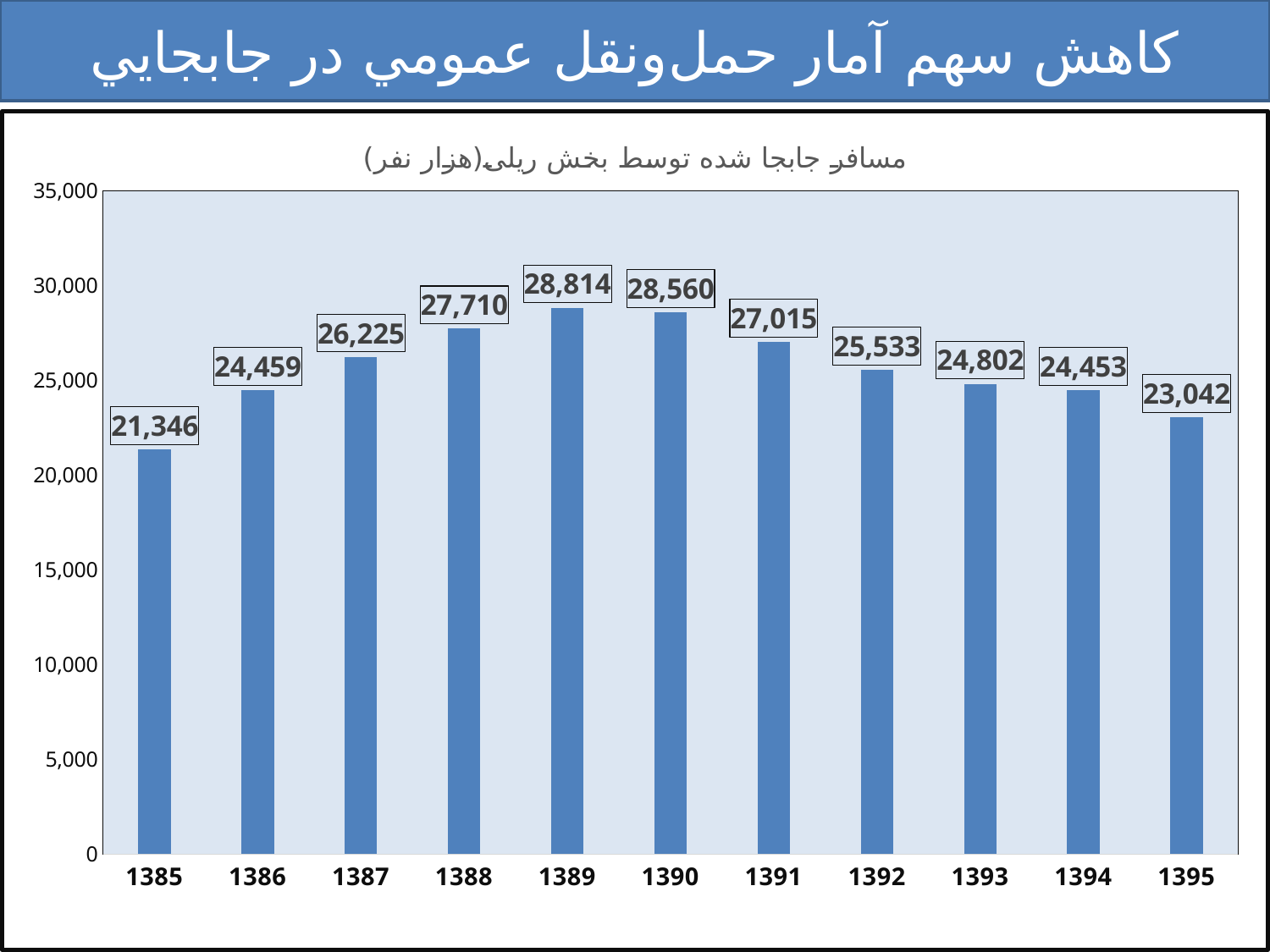
Do the values rise or fall from 1390 to 1395? Fall What is the value for 1385? 21,346 What is the difference between the values for 1389 and 1395? 5,772 What kind of chart is shown on the slide? Bar chart Which is larger, the value for 1388 or the value for 1391? 1388 Which year has the lowest value? 1385 What is the value for 1395? 23,042 What is the title of the chart? مسافر جابجا شده توسط بخش ریلی(هزار نفر) Is the value for 1392 greater or less than 25,000? greater What is the value for 1389? 28,814 Which year has the highest value? 1389 How many years are shown on the x axis? 11